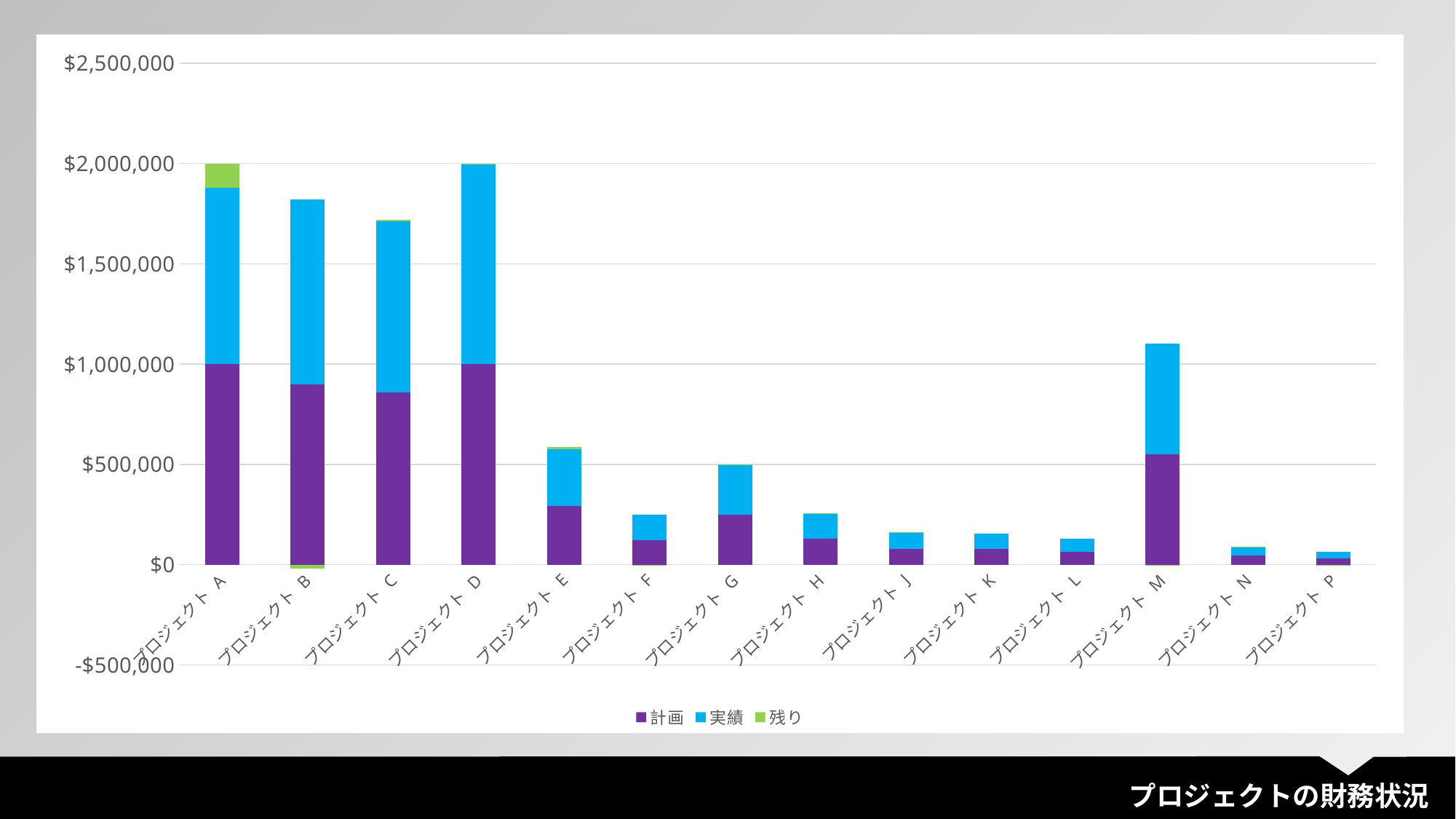
Which has the larger total stacked value, プロジェクト B or プロジェクト C? プロジェクト B How many series does the legend list? 3 Is the total stacked value for プロジェクト F greater or less than $500,000? less How many projects are shown on the x axis? 14 Is the 計画 value for プロジェクト B greater or less than $1,000,000? less What kind of chart is shown on the slide? bar chart Is the total stacked value for プロジェクト E greater or less than $500,000? greater What are the three legend entries? 計画, 実績, 残り Which series is shown in green? 残り Which has the larger total stacked value, プロジェクト H or プロジェクト J? プロジェクト H Which project has the lowest total stacked value? プロジェクト P